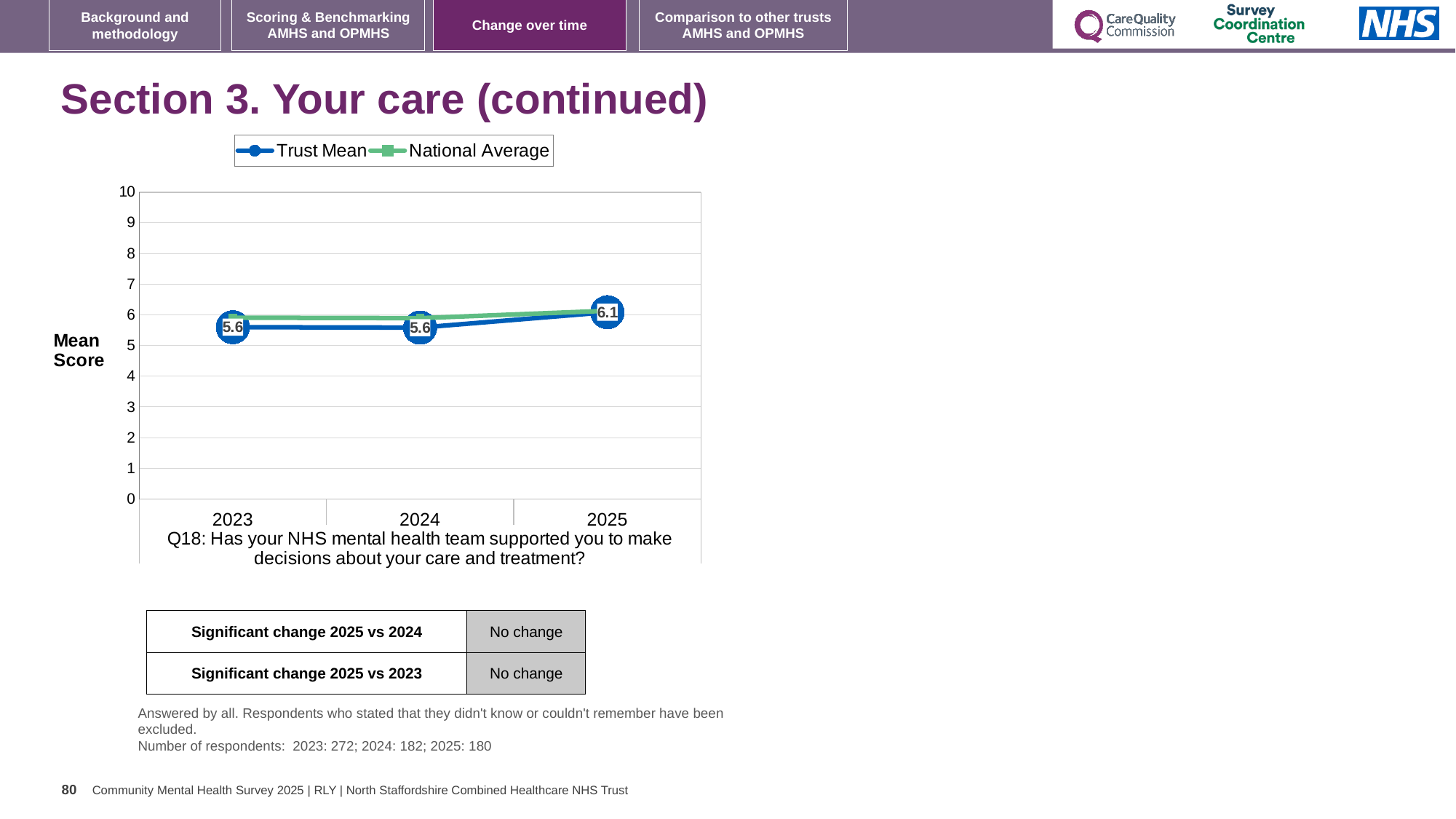
How many years are plotted on the x axis? 3 How many series does the legend list? 2 In which year is the Trust Mean highest? 2025 What is the difference between the Trust Mean in 2025 and in 2023? 0.5 What is the Trust Mean value for 2025? 6.1 Which is larger, the Trust Mean for 2025 or for 2024? 2025 Does the Trust Mean rise or fall from 2024 to 2025? rise What is the Trust Mean value for 2023? 5.6 Is the National Average value for 2023 greater or less than 5? greater What kind of chart is shown? line chart What is the Trust Mean value for 2024? 5.6 Is the National Average value for 2024 greater or less than 7? less